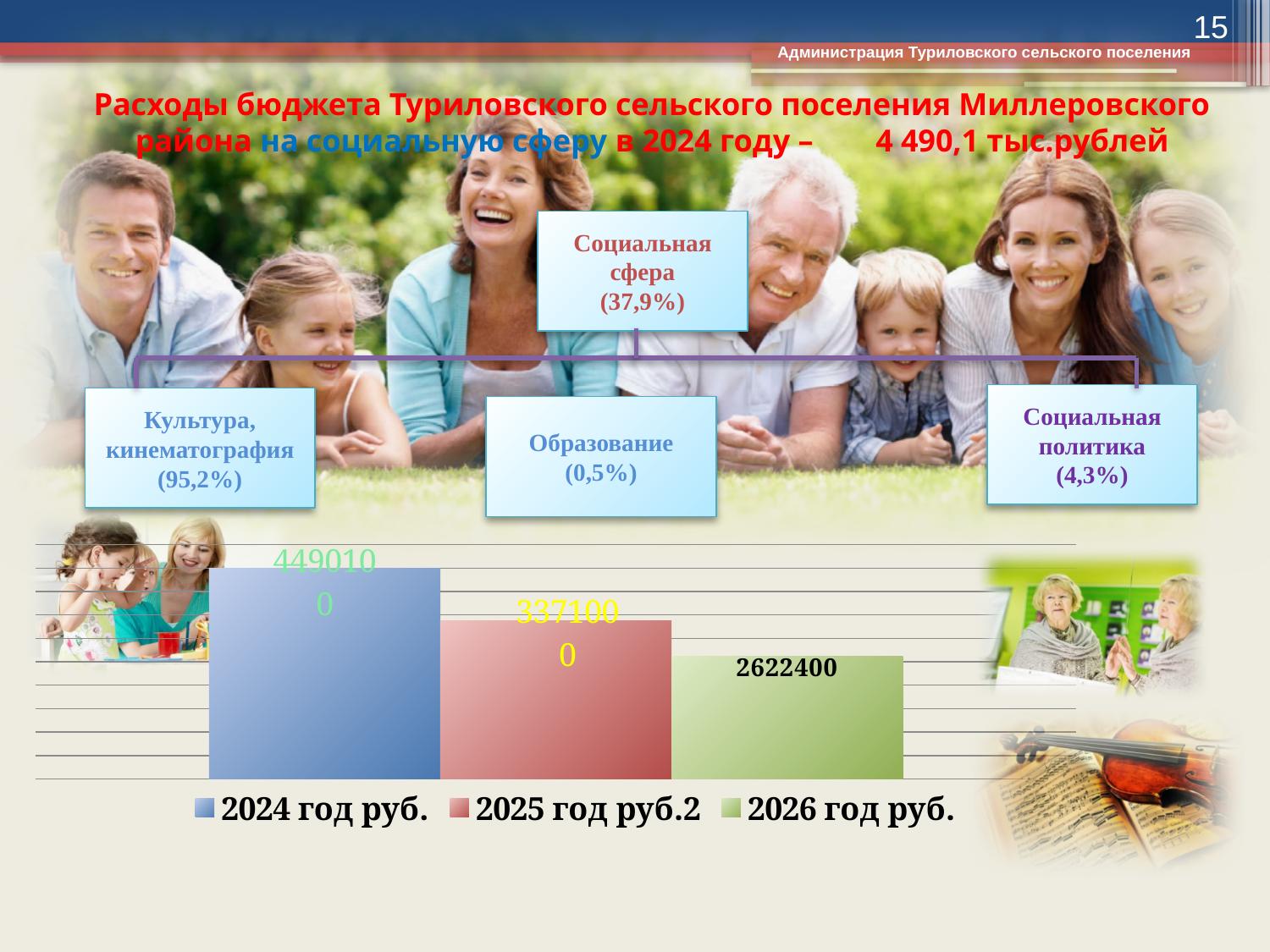
What is the value shown for the 2024 год руб. bar? 4490100 Which series has the lowest value in the chart? 2026 год руб. What is the value shown for the 2026 год руб. bar? 2622400 Which is larger, the 2025 год руб.2 value or the 2026 год руб. value? 2025 год руб.2 How many bars are plotted in the chart? 3 Which series has the highest value in the chart? 2024 год руб. Do the bar values rise or fall from 2024 to 2026 across the chart? fall How many series does the chart legend list? 3 What is the difference between the 2025 год руб.2 value and the 2026 год руб. value? 748600 What kind of chart is shown at the bottom of the slide? bar chart What is the value shown for the 2025 год руб.2 bar? 3371000 What is the difference between the 2024 год руб. value and the 2025 год руб.2 value? 1119100